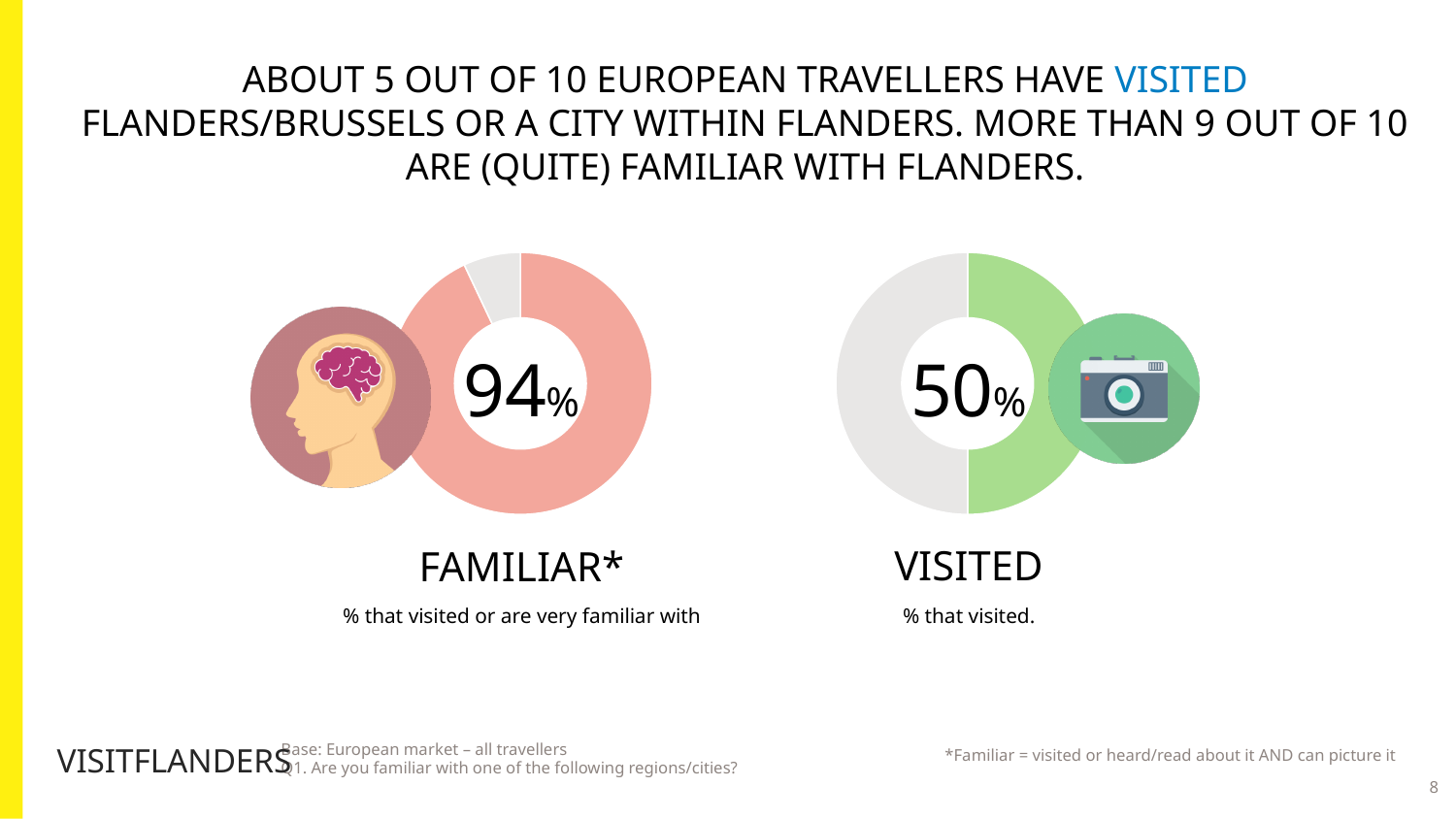
What is the subtitle text under the FAMILIAR* chart? % that visited or are very familiar with On the VISITED chart, what percentage is shown in the centre of the donut? 50% What is the difference in percentage points between the FAMILIAR* value and the VISITED value? 44 What type of chart is used to show the FAMILIAR* value? Donut chart What type of chart is used to show the VISITED value? Donut chart On the FAMILIAR* chart, what percentage is shown in the centre of the donut? 94% Which chart shows the higher percentage, FAMILIAR* or VISITED? FAMILIAR* On the VISITED chart, what share of the donut is filled by the coloured (green) segment? 50% How many donut charts are on the slide? 2 What colour is the filled segment of the VISITED donut chart? Green Is the value on the VISITED chart greater or less than 90%? less